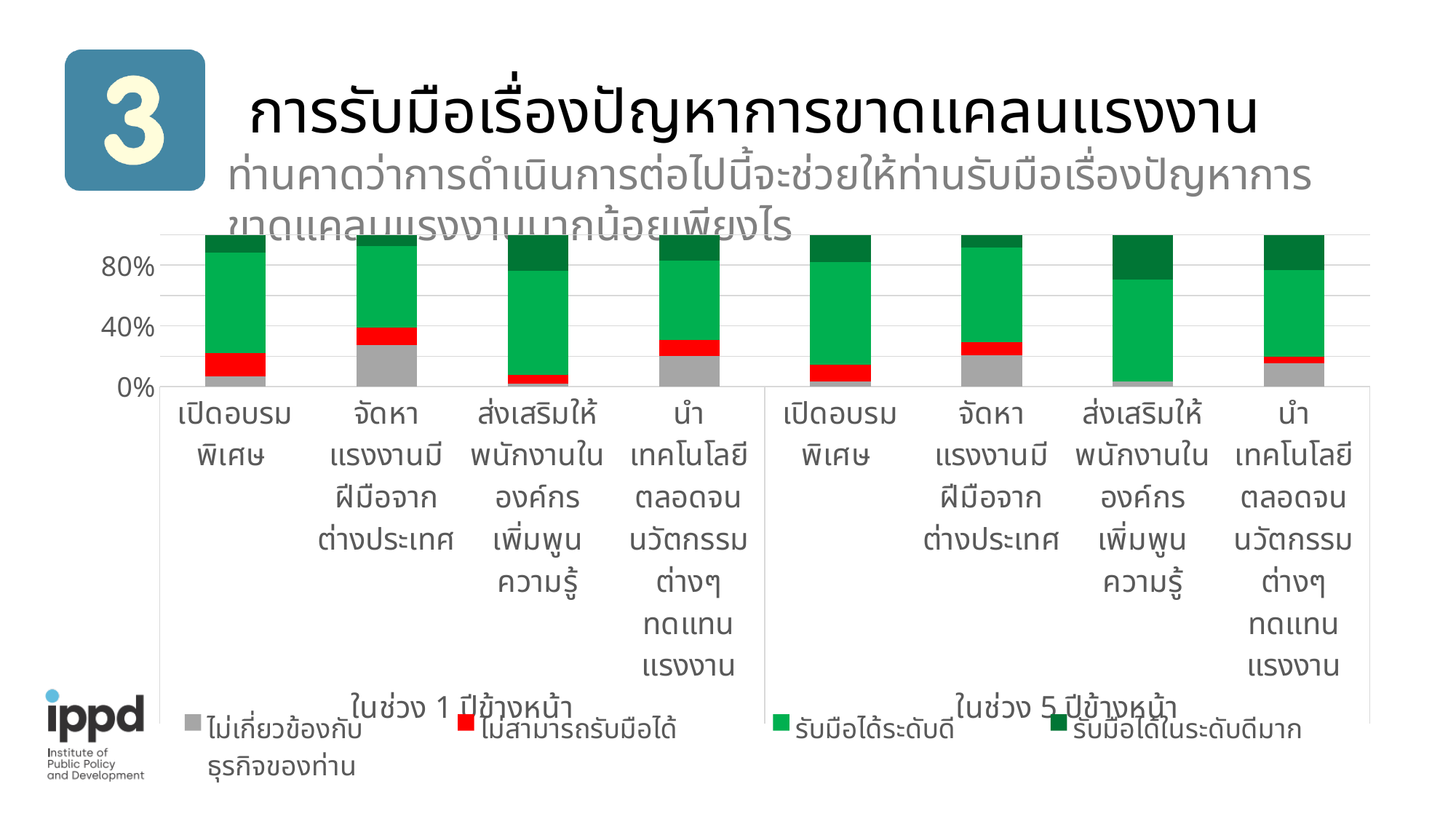
In the group ในช่วง 1 ปีข้างหน้า, which category has the largest grey (ไม่เกี่ยวข้องกับธุรกิจของท่าน) segment? จัดหาแรงงานมีฝีมือจากต่างประเทศ In the group ในช่วง 1 ปีข้างหน้า, is the grey (ไม่เกี่ยวข้องกับธุรกิจของท่าน) segment for จัดหาแรงงานมีฝีมือจากต่างประเทศ greater or less than 40%? less How many categories are shown in the group ในช่วง 1 ปีข้างหน้า? 4 In the group ในช่วง 1 ปีข้างหน้า, is the dark green (รับมือได้ในระดับดีมาก) segment larger for ส่งเสริมให้พนักงานในองค์กรเพิ่มพูนความรู้ or for จัดหาแรงงานมีฝีมือจากต่างประเทศ? ส่งเสริมให้พนักงานในองค์กรเพิ่มพูนความรู้ How many series does the legend list? 4 How many bars are plotted in the chart in total? 8 Which legend entry is shown in red? ไม่สามารถรับมือได้ What kind of chart is shown on the slide? Stacked bar chart In the group ในช่วง 5 ปีข้างหน้า, is the top of the green (รับมือได้ระดับดี) segment for ส่งเสริมให้พนักงานในองค์กรเพิ่มพูนความรู้ greater or less than 80%? less Which legend entry is shown in grey? ไม่เกี่ยวข้องกับธุรกิจของท่าน In the group ในช่วง 1 ปีข้างหน้า, is the top of the green (รับมือได้ระดับดี) segment for จัดหาแรงงานมีฝีมือจากต่างประเทศ greater or less than 80%? greater In the group ในช่วง 5 ปีข้างหน้า, which category has the largest dark green (รับมือได้ในระดับดีมาก) segment? ส่งเสริมให้พนักงานในองค์กรเพิ่มพูนความรู้